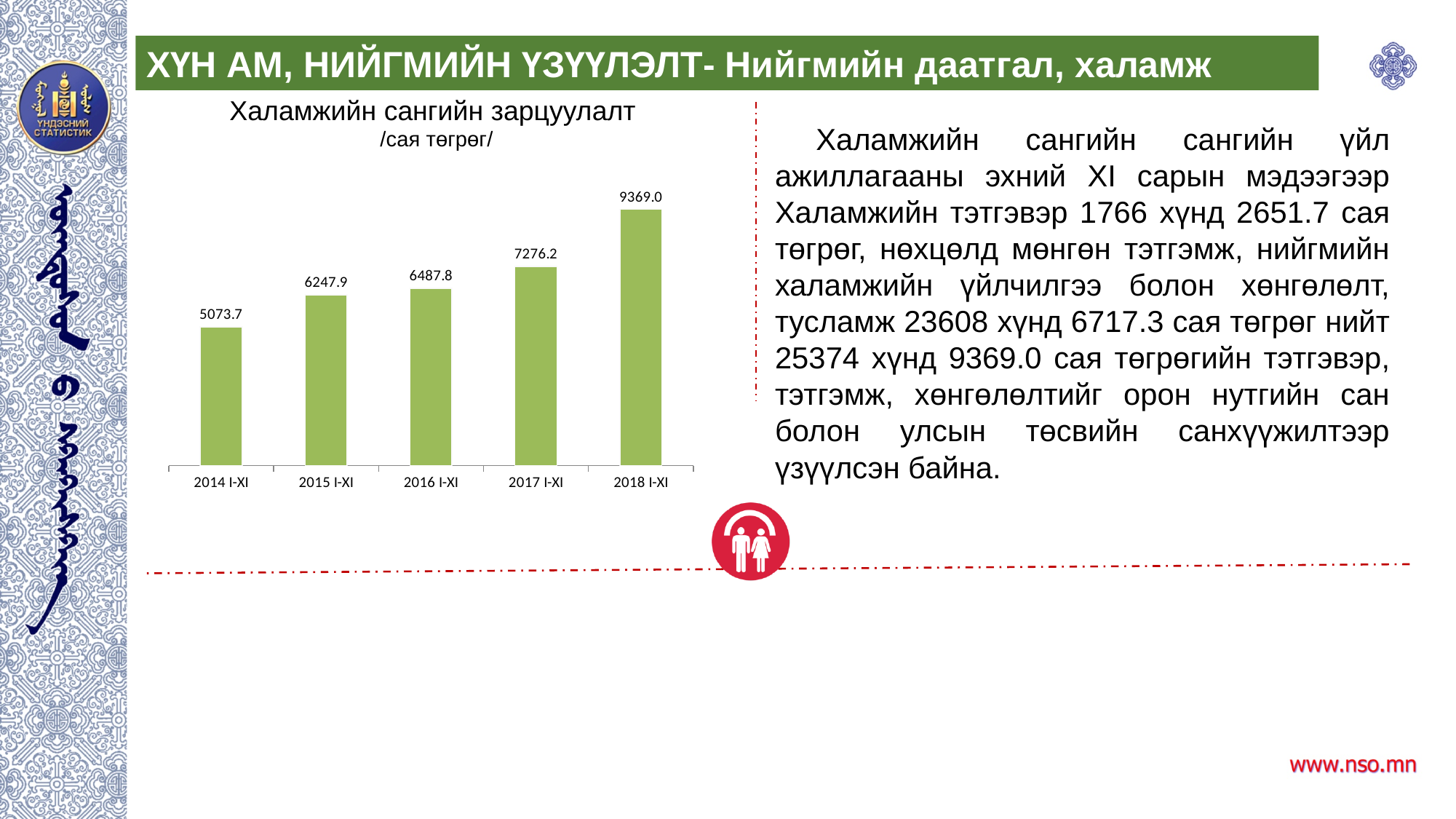
Which period has the highest value in the chart? 2018 I-XI Do the values rise or fall from 2014 I-XI to 2018 I-XI? Rise What is the value for 2014 I-XI in the chart? 5073.7 Which period has the lowest value in the chart? 2014 I-XI What is the value for 2018 I-XI in the chart? 9369.0 What unit is given under the chart title? сая төгрөг What is the difference between the values for 2017 I-XI and 2016 I-XI? 788.4 What is the difference between the values for 2018 I-XI and 2014 I-XI? 4295.3 What is the value for 2016 I-XI in the chart? 6487.8 Which is larger, the value for 2015 I-XI or the value for 2017 I-XI? 2017 I-XI What kind of chart is shown on the slide? Bar chart How many periods (bars) are shown in the chart? 5